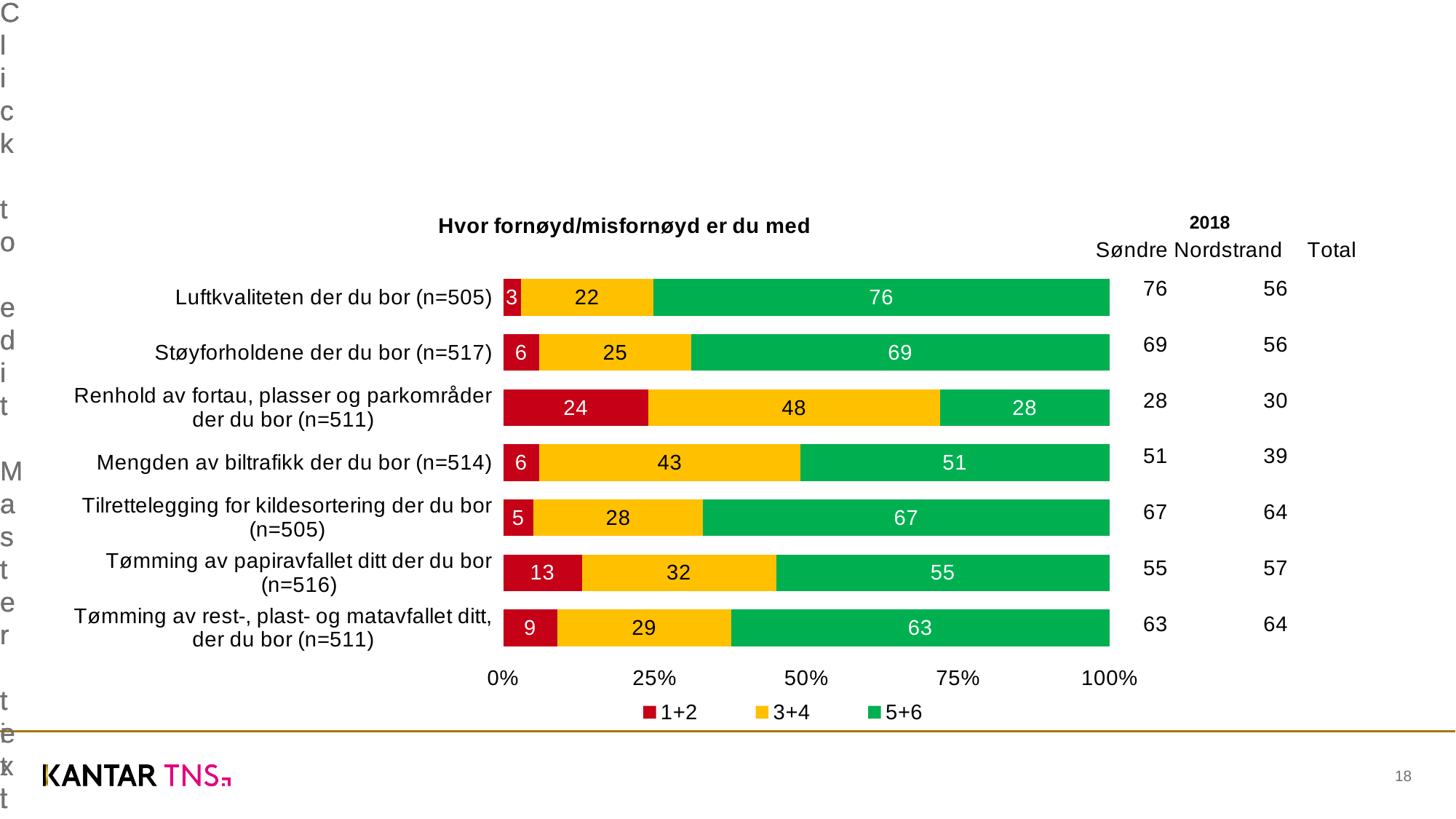
Which category has the lowest value for the 5+6 series? Renhold av fortau, plasser og parkområder der du bor (n=511) What is the value of the 5+6 series for "Luftkvaliteten der du bor (n=505)"? 76 Which has a larger 5+6 value: "Støyforholdene der du bor (n=517)" or "Tilrettelegging for kildesortering der du bor (n=505)"? Støyforholdene der du bor (n=517) What is the difference between the 3+4 value for "Renhold av fortau, plasser og parkområder der du bor (n=511)" and the 3+4 value for "Luftkvaliteten der du bor (n=505)"? 26 Which category has the highest value for the 1+2 series? Renhold av fortau, plasser og parkområder der du bor (n=511) How many series does the legend list? 3 What is the value of the 3+4 series for "Mengden av biltrafikk der du bor (n=514)"? 43 How many categories are shown in the chart? 7 What is the total of the stacked bar for "Mengden av biltrafikk der du bor (n=514)"? 100 Which category has the highest value for the 5+6 series? Luftkvaliteten der du bor (n=505) What is the value of the 1+2 series for "Renhold av fortau, plasser og parkområder der du bor (n=511)"? 24 What kind of chart is shown on the slide? Stacked bar chart